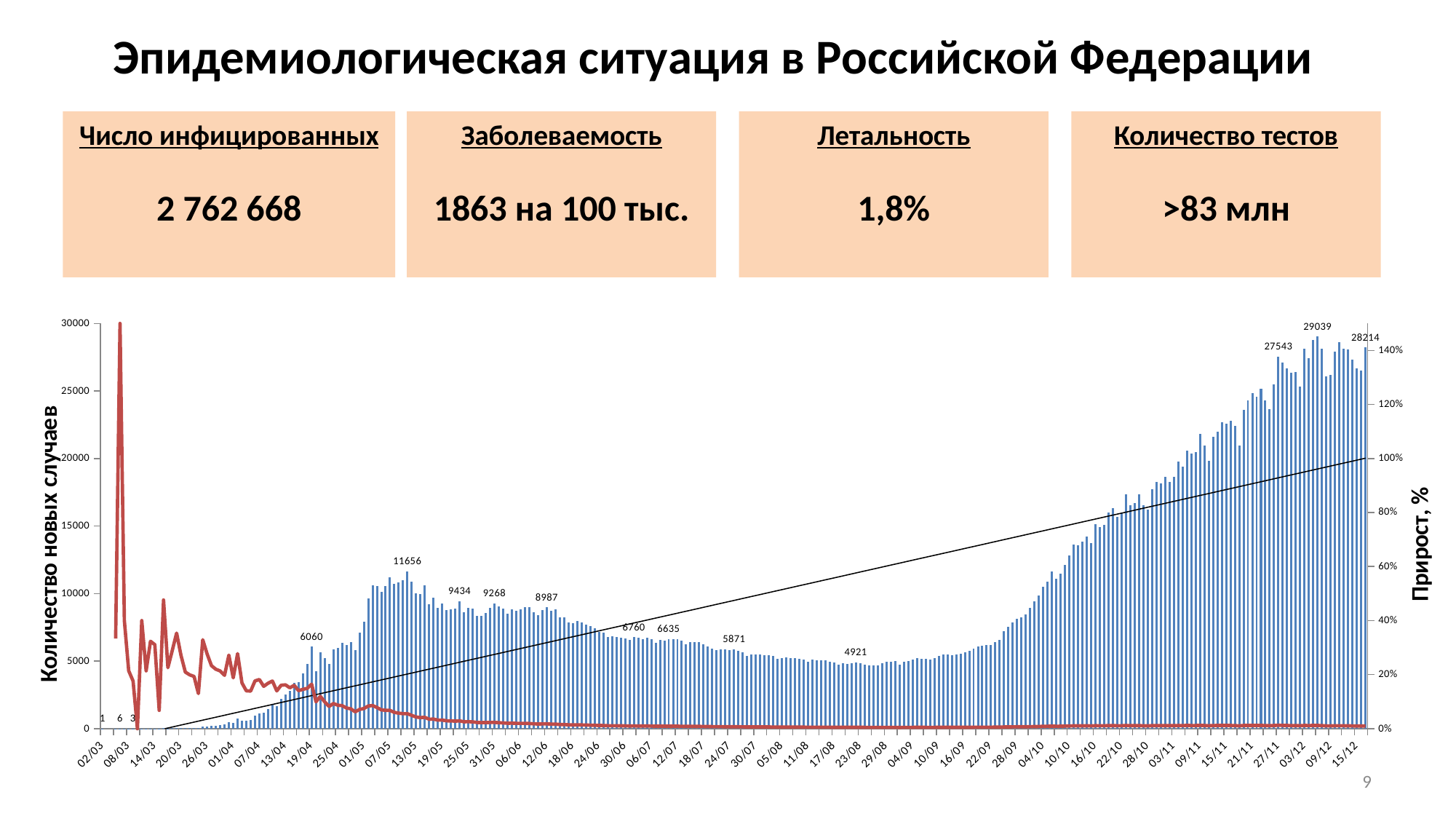
Is the bar value near 16/10 greater or less than 10000? greater What is the difference between the labelled values 11656 and 9434 in the chart? 2222 What kind of chart is used to show the number of new cases on the slide? bar chart What is the highest data label shown on the bars in the chart? 29039 What value is labelled on the bar near 27/11 in the chart? 27543 What is the difference between the labelled values 29039 and 27543 in the chart? 1496 Which labelled value is larger in the chart: 9434 (near 25/05) or 9268 (near 31/05)? 9434 What value is labelled on the bar near 23/08 in the chart? 4921 Is the bar value near 28/09 greater or less than 10000? less What value is labelled on the peak bar near 13/05 in the chart? 11656 What is the title of the right-hand vertical axis of the chart? Прирост, % Do the bar values rise or fall from 23/08 to 15/12 in the chart? rise